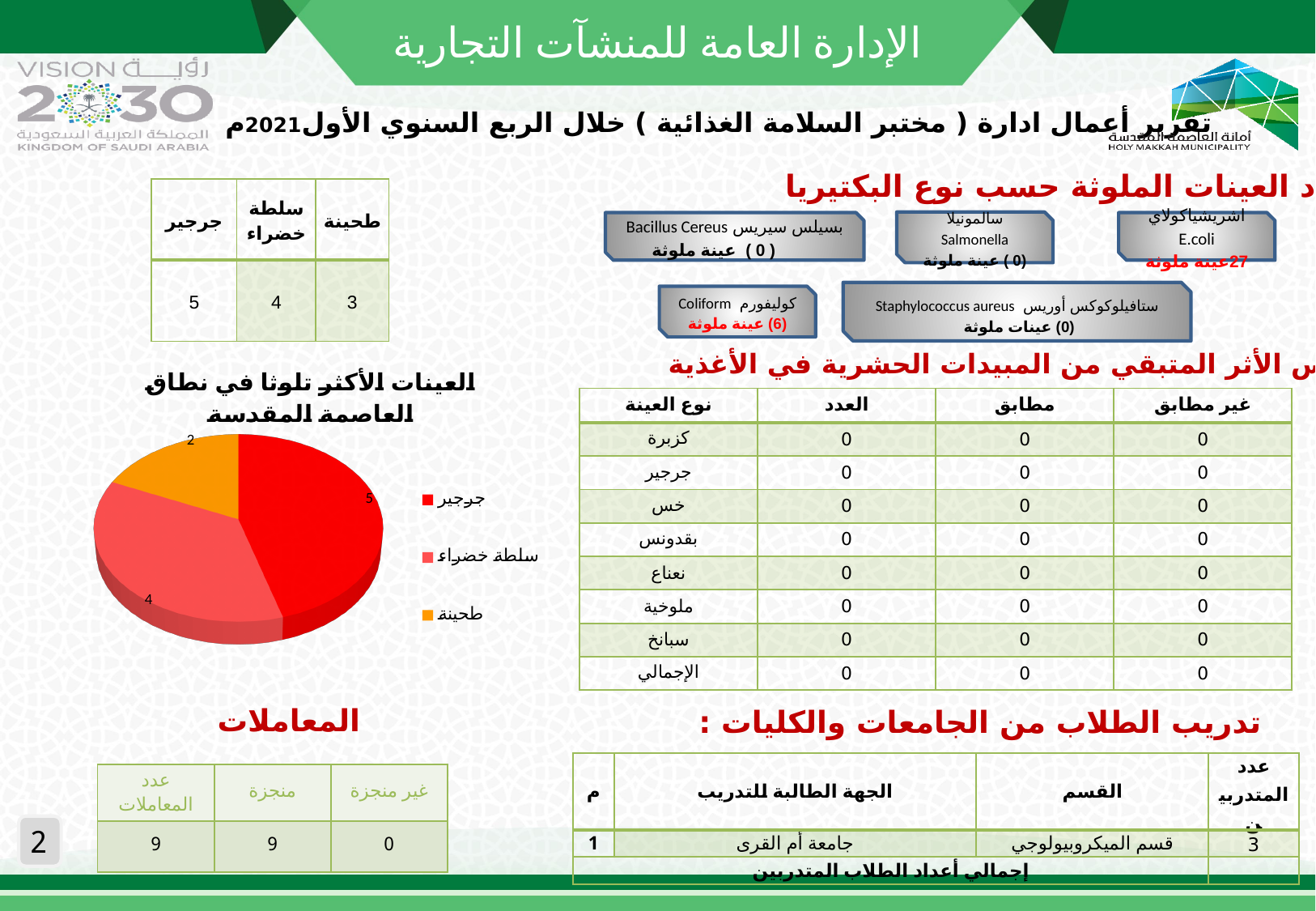
Which colour represents سلطة خضراء in the pie chart? pink (light red) Which category has the largest slice in the pie chart? جرجير What is the title of the pie chart? العينات الأكثر تلوثا في نطاق العاصمة المقدسة What is the value shown for سلطة خضراء in the pie chart? 4 What kind of chart is shown on the slide? pie chart In the pie chart, which is larger: جرجير or طحينة? جرجير How many entries does the pie chart's legend list? 3 Which category has the smallest slice in the pie chart? طحينة How many slices does the pie chart have? 3 What is the value shown for جرجير in the pie chart? 5 What is the difference between the values for جرجير and طحينة in the pie chart? 3 What is the value shown for طحينة in the pie chart? 2